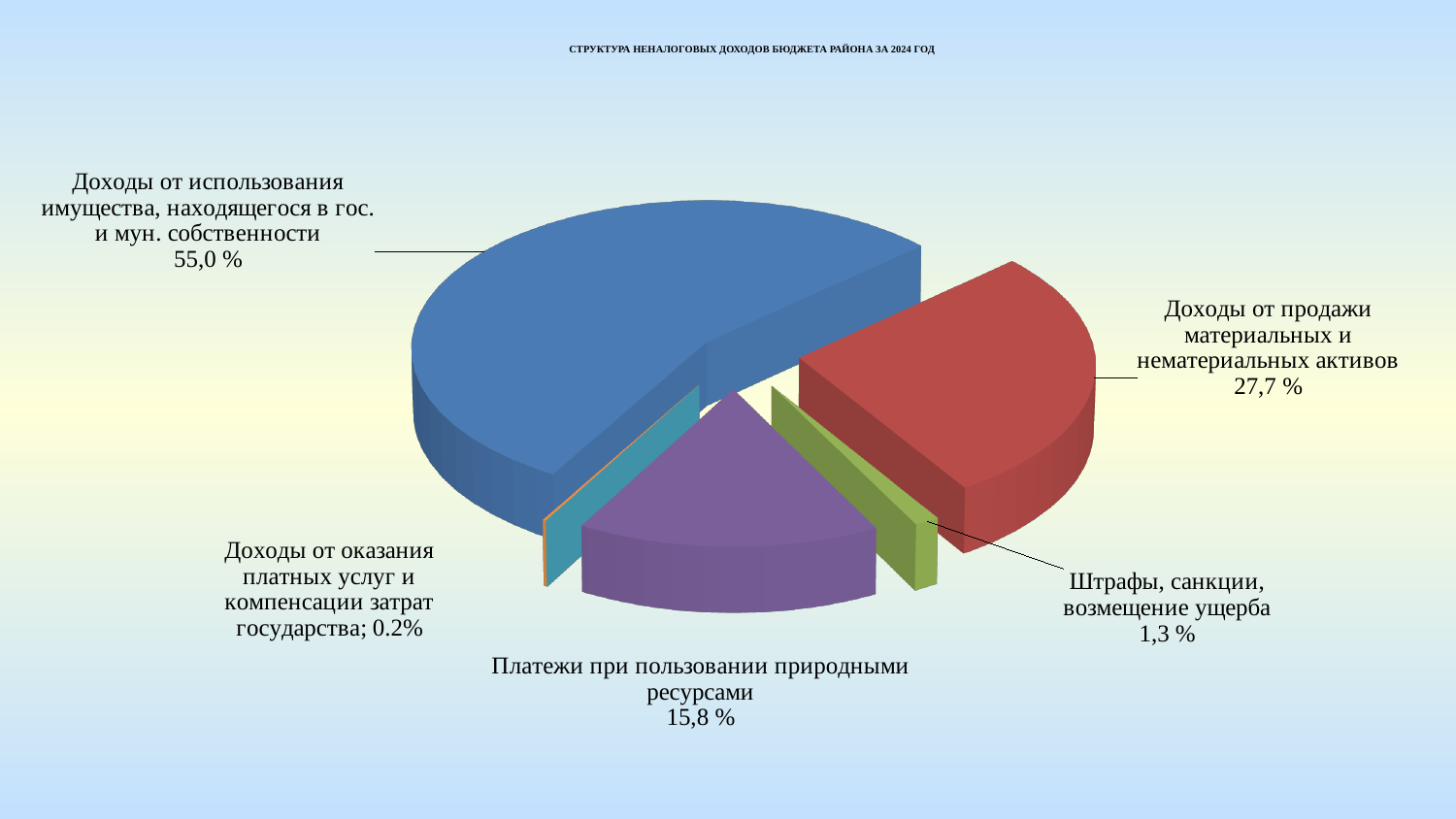
Какова доля доходов от продажи материальных и нематериальных активов? 27,7 % Какова доля доходов от использования имущества, находящегося в гос. и мун. собственности? 55,0 % Что больше: доля платежей при пользовании природными ресурсами или доля штрафов, санкций, возмещения ущерба? Платежи при пользовании природными ресурсами Сколько категорий показано на круговой диаграмме? 5 На сколько процентных пунктов доля доходов от использования имущества больше доли доходов от продажи материальных и нематериальных активов? 27,3 Какая категория имеет наибольшую долю в структуре неналоговых доходов? Доходы от использования имущества, находящегося в гос. и мун. собственности Как называется диаграмма на слайде? Структура неналоговых доходов бюджета района за 2024 год Какова доля штрафов, санкций, возмещения ущерба? 1,3 % Какая категория имеет наименьшую долю в структуре неналоговых доходов? Доходы от оказания платных услуг и компенсации затрат государства Какова доля платежей при пользовании природными ресурсами? 15,8 % Какова доля доходов от оказания платных услуг и компенсации затрат государства? 0.2% Какой тип диаграммы показан на слайде? Круговая диаграмма